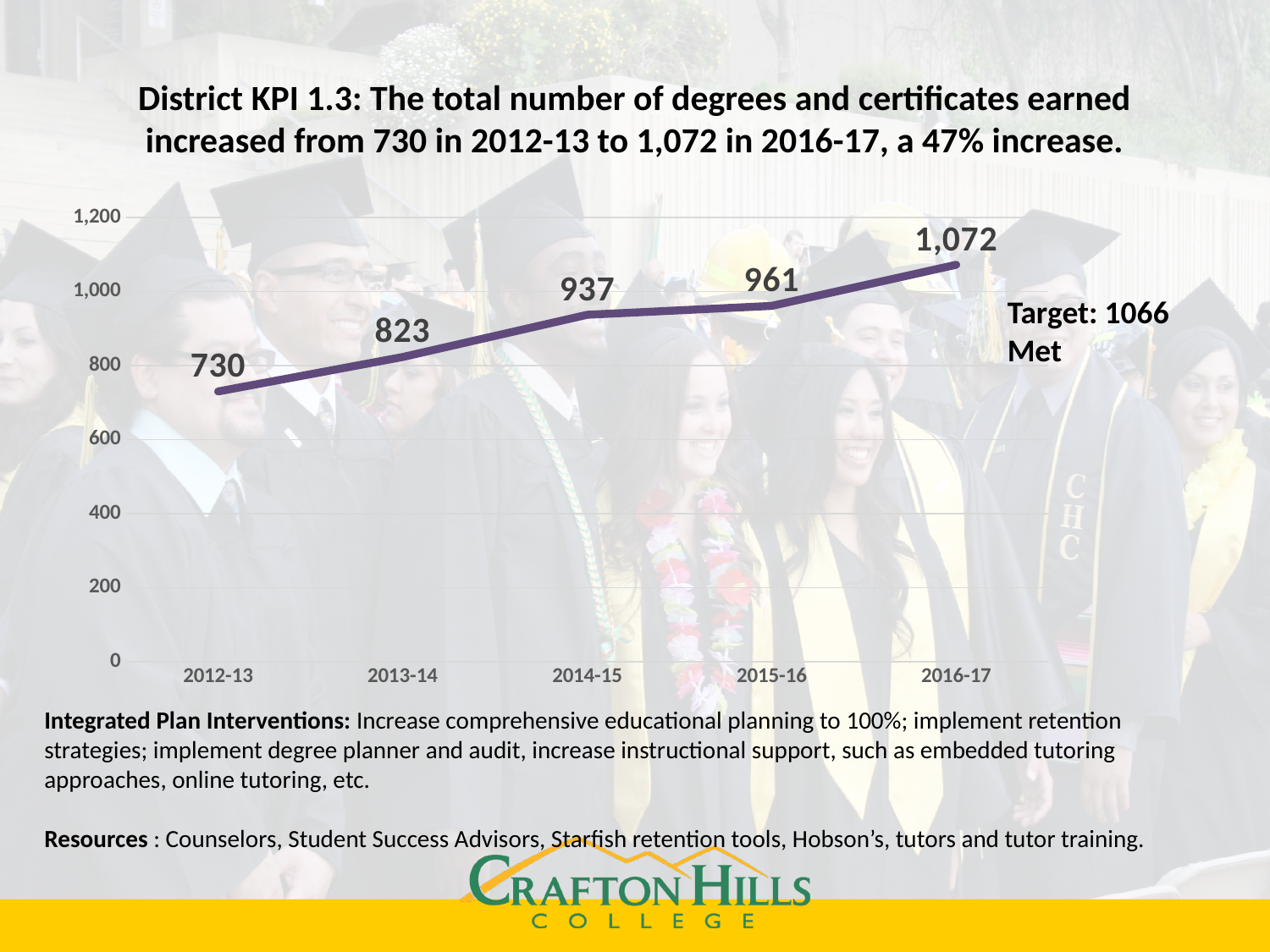
Which year has the highest number of degrees and certificates earned? 2016-17 Which year has the lowest number of degrees and certificates earned? 2012-13 What is the difference between the values for 2016-17 and 2012-13? 342 What is the total number of degrees and certificates earned in 2014-15? 937 How many years are plotted on the chart? 5 What is the value plotted for 2016-17? 1,072 Do the values rise or fall from 2012-13 to 2016-17? rise Is the value for 2013-14 greater or less than 1,000? less What is the value plotted for 2012-13? 730 Which is larger, the value for 2013-14 or the value for 2015-16? 2015-16 What kind of chart is shown on the slide? line chart What is the difference between the values for 2015-16 and 2014-15? 24